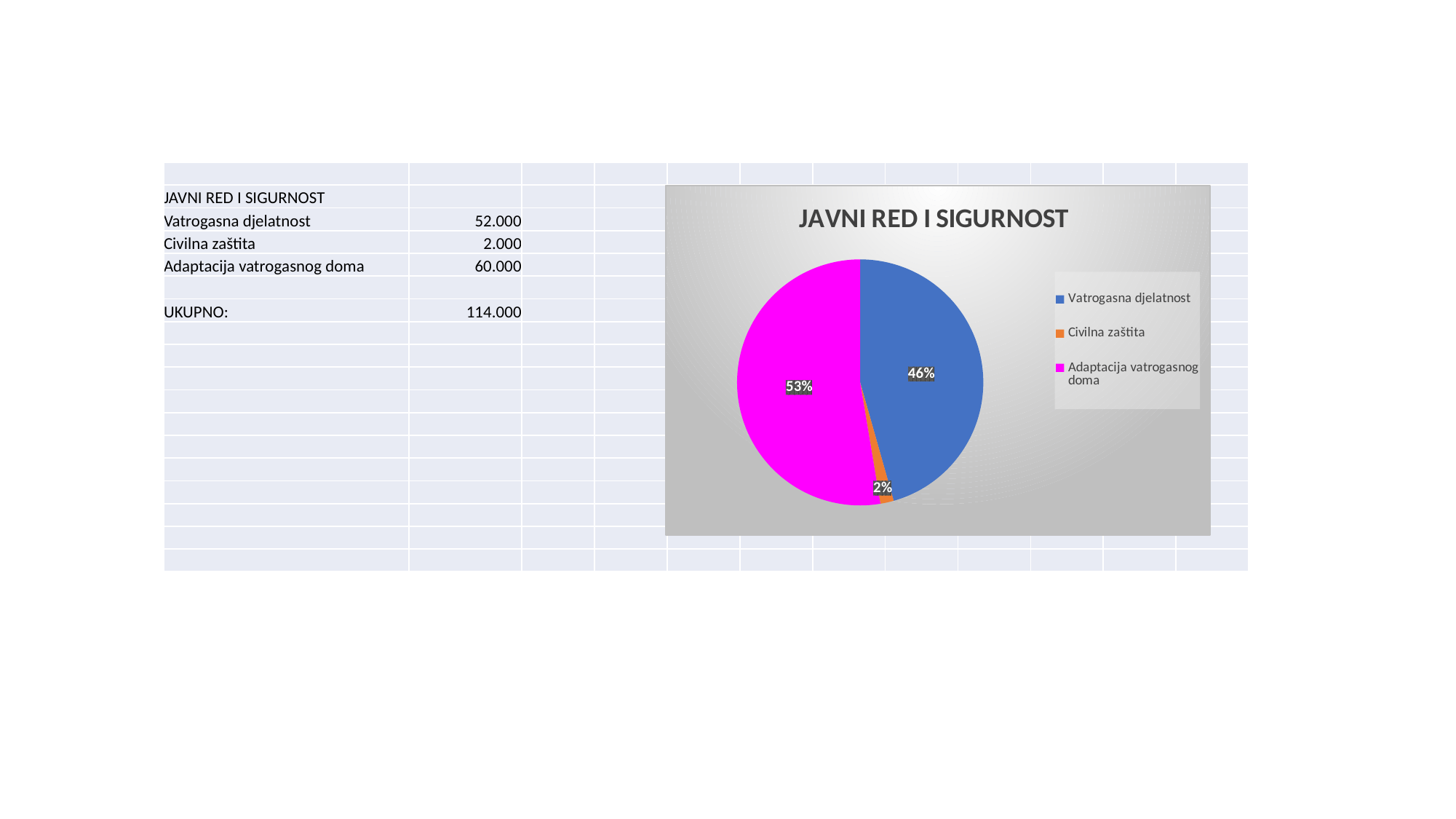
What is the difference in percentage points between the Adaptacija vatrogasnog doma slice and the Vatrogasna djelatnost slice? 7% Which category has the largest slice of the pie? Adaptacija vatrogasnog doma What share of the pie does Vatrogasna djelatnost represent? 46% How many slices does the pie chart have? 3 What share of the pie does Civilna zaštita represent? 2% What share of the pie does Adaptacija vatrogasnog doma represent? 53% How many entries does the legend list? 3 Which slice is larger: Vatrogasna djelatnost or Civilna zaštita? Vatrogasna djelatnost Which category has the smallest slice of the pie? Civilna zaštita What colour is the Civilna zaštita slice in the pie chart? orange What is the title of the chart? JAVNI RED I SIGURNOST What kind of chart is shown on the slide? pie chart